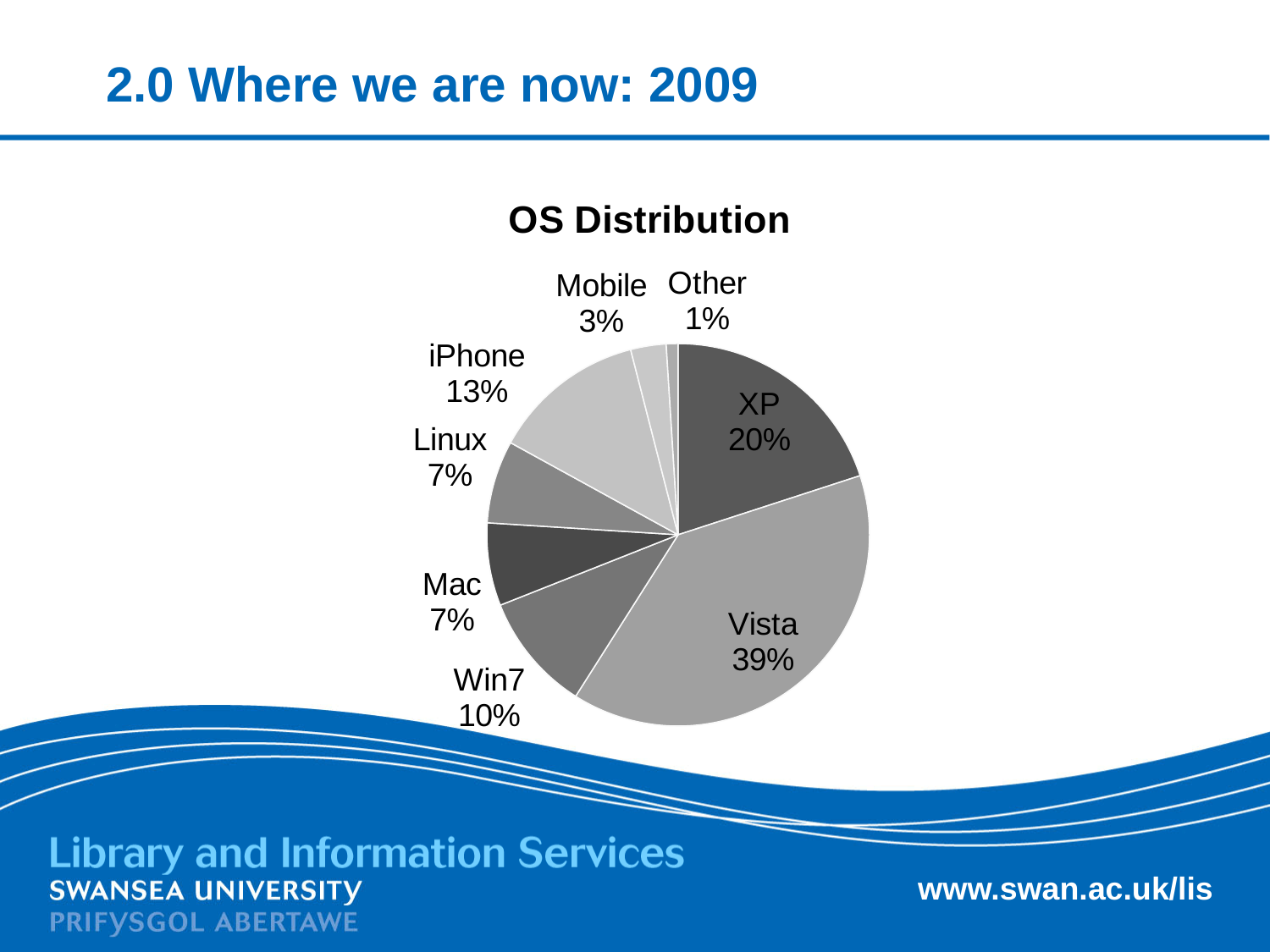
How many categories are shown in the OS Distribution pie chart? 8 What is the title of the chart on the slide? OS Distribution What is the combined share of Linux and Mac in the OS Distribution chart? 14% What is the difference between the Vista and XP shares in the OS Distribution chart? 19% Which is larger in the OS Distribution chart, Win7 or iPhone? iPhone Which category has the smallest slice in the OS Distribution chart? Other What share of the pie does Vista have in the OS Distribution chart? 39% What kind of chart is shown on the slide? Pie chart What is the value shown for XP in the OS Distribution chart? 20% What percentage is shown for iPhone in the OS Distribution chart? 13% Which category has the largest slice in the OS Distribution chart? Vista What is the value shown for Mobile in the OS Distribution chart? 3%